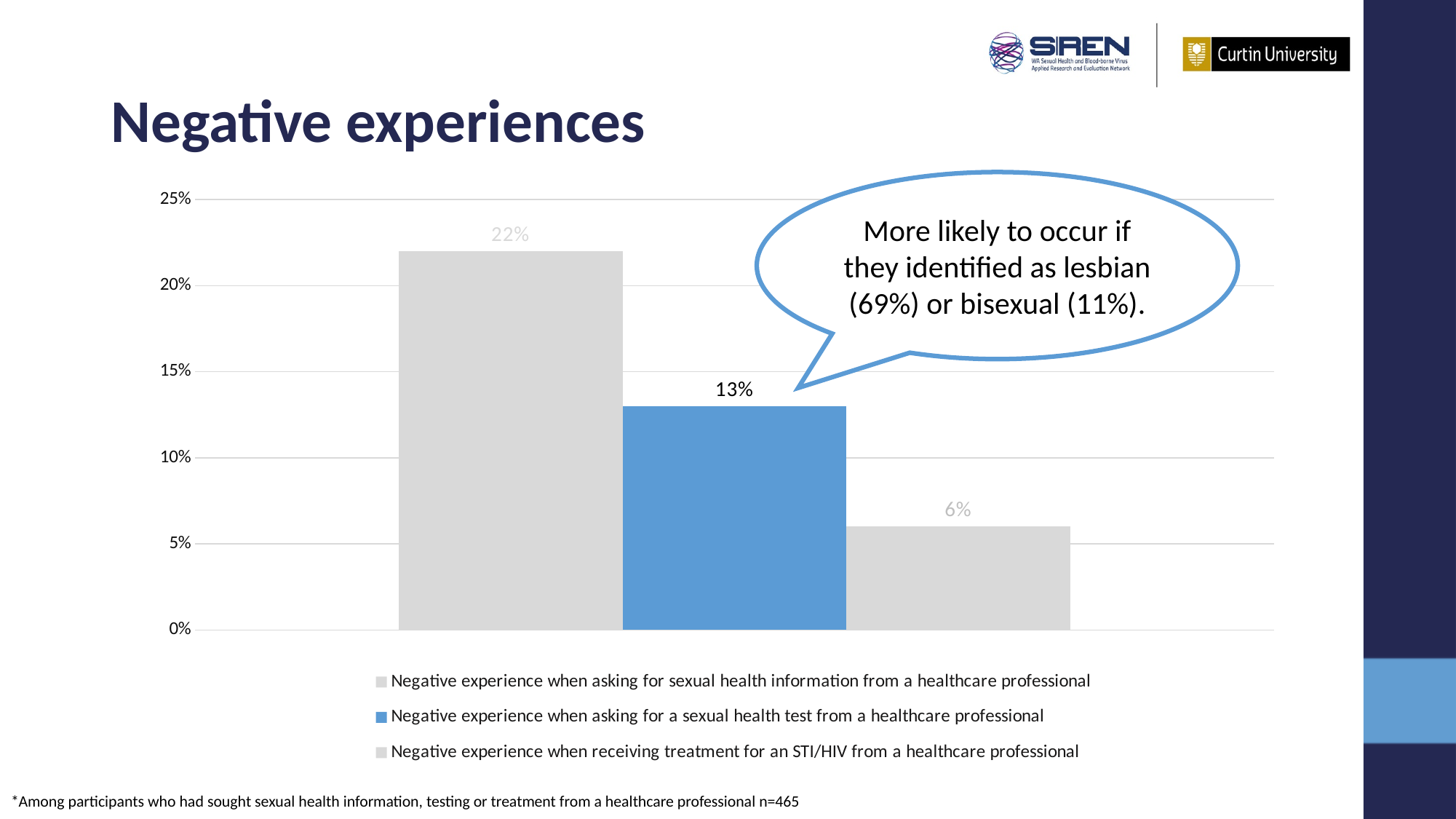
Which series has the highest value? Negative experience when asking for sexual health information from a healthcare professional Which series is shown in blue? Negative experience when asking for a sexual health test from a healthcare professional Is the value for negative experience when asking for sexual health information greater or less than 20%? greater What is the difference between the value for asking for sexual health information and the value for asking for a sexual health test? 9% What is the value for negative experience when receiving treatment for an STI/HIV from a healthcare professional? 6% How many series does the legend list? 3 What kind of chart is shown on the slide? Bar chart Which series has the lowest value? Negative experience when receiving treatment for an STI/HIV from a healthcare professional What is the difference between the value for asking for a sexual health test and the value for receiving treatment for an STI/HIV? 7% What is the value for negative experience when asking for sexual health information from a healthcare professional? 22% What is the value for negative experience when asking for a sexual health test from a healthcare professional? 13% Which is larger: the value for asking for a sexual health test or the value for receiving treatment for an STI/HIV? Asking for a sexual health test